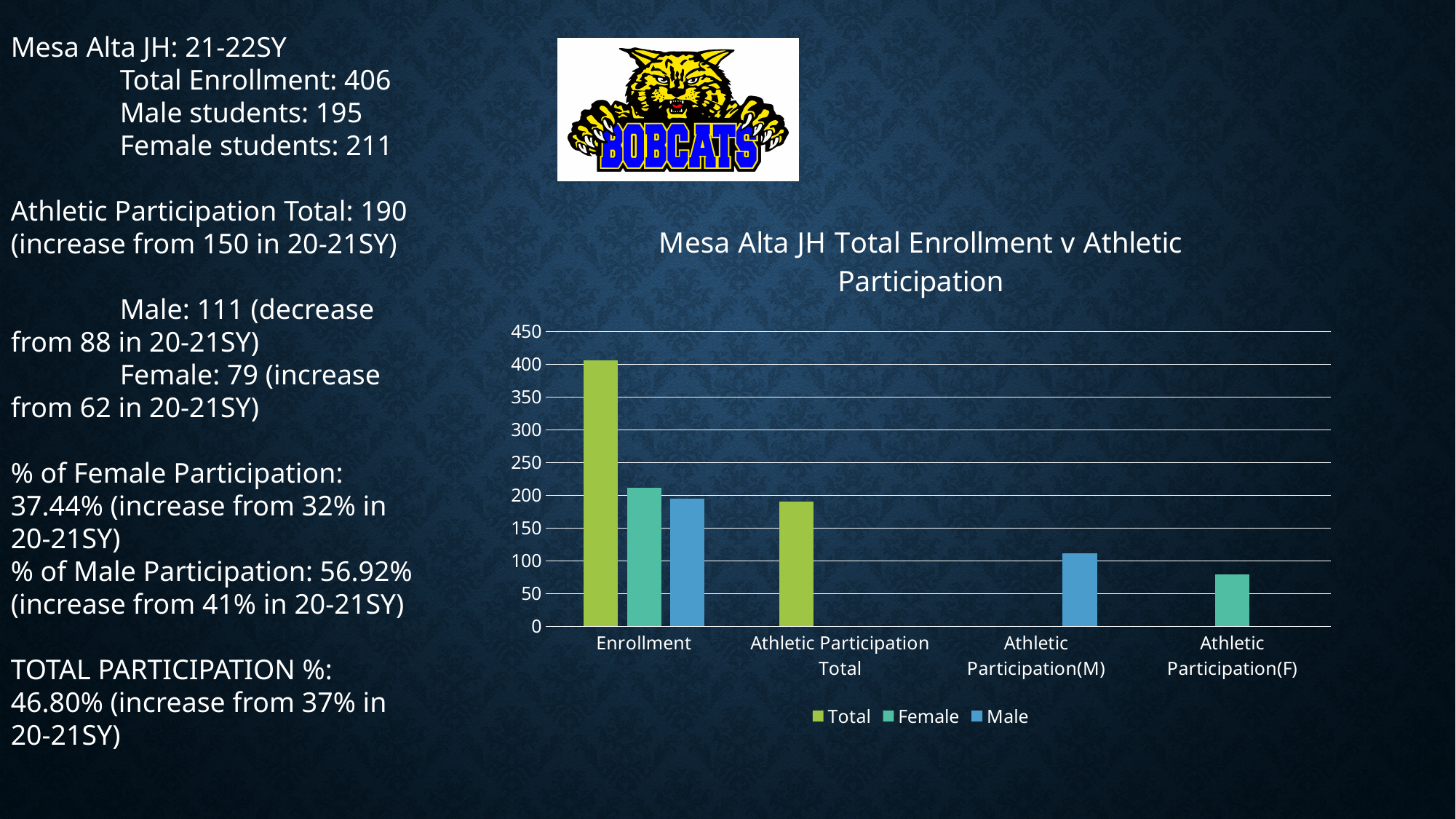
Which category has the tallest bar in the chart? Enrollment In the Enrollment category, which is larger, the Female bar or the Male bar? Female What kind of chart is shown on the slide? bar chart Is the Female bar for Athletic Participation(F) greater or less than 100? less Is the Total bar for Enrollment greater or less than 400? greater Which category has the shortest bar in the chart? Athletic Participation(F) Is the Total bar for Athletic Participation Total greater or less than 200? less How many series does the chart legend list? 3 How many categories are shown on the x axis of the chart? 4 What is the title of the chart? Mesa Alta JH Total Enrollment v Athletic Participation